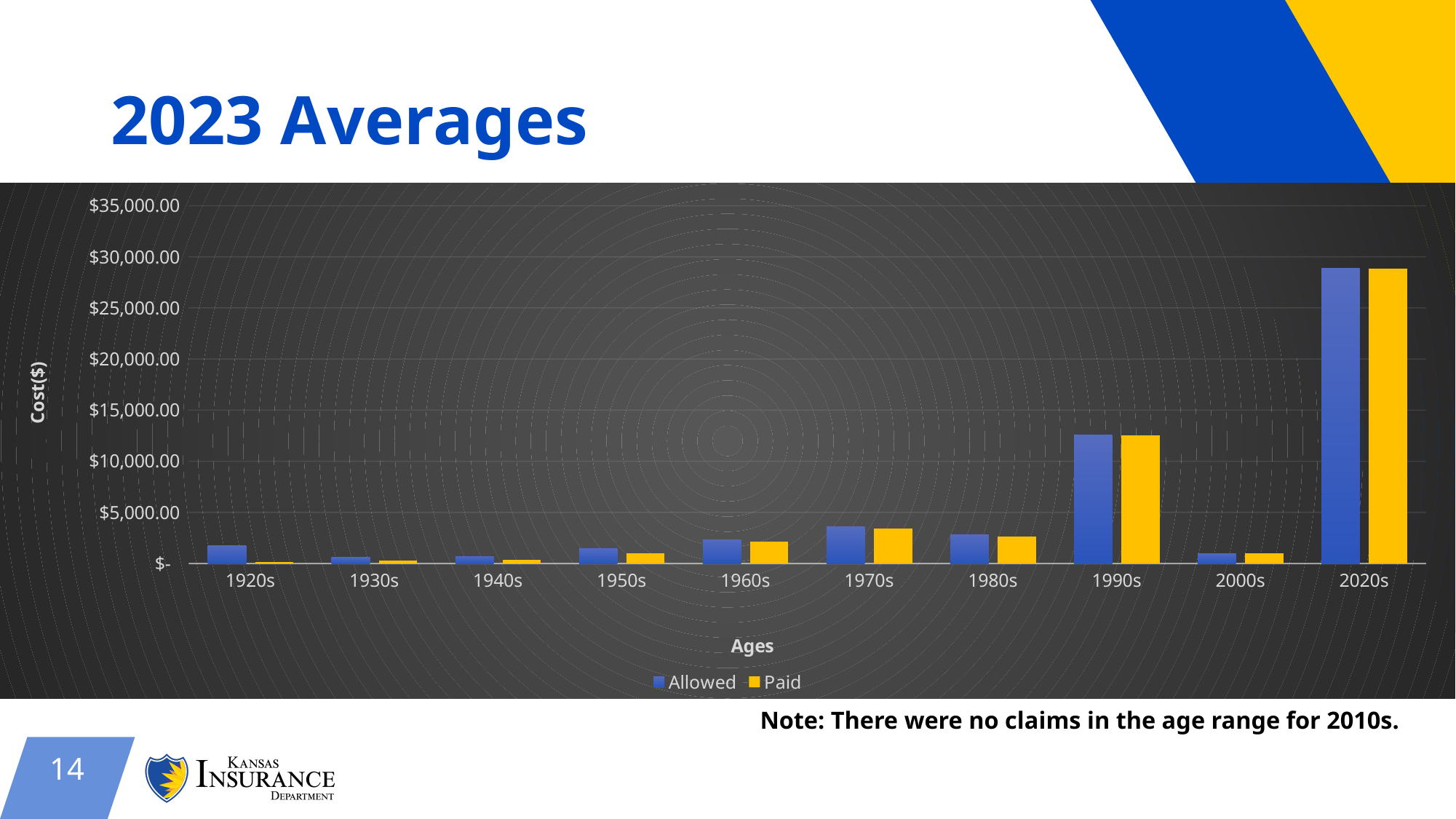
Which age category has the highest Allowed value? 2020s Is the Allowed value for 1990s greater or less than $10,000.00? greater Is the Allowed value for 2020s greater or less than $25,000.00? greater Is the Paid value for 2020s greater or less than $30,000.00? less What kind of chart is shown on the slide? Bar chart What is the label on the vertical axis of the chart? Cost($) Which is larger, the Allowed value for 1990s or the Allowed value for 1970s? 1990s For the 1920s, which is larger, the Allowed value or the Paid value? Allowed Which age category has the lowest Paid value? 1920s How many series does the legend list? 2 How many age categories are shown on the x axis? 10